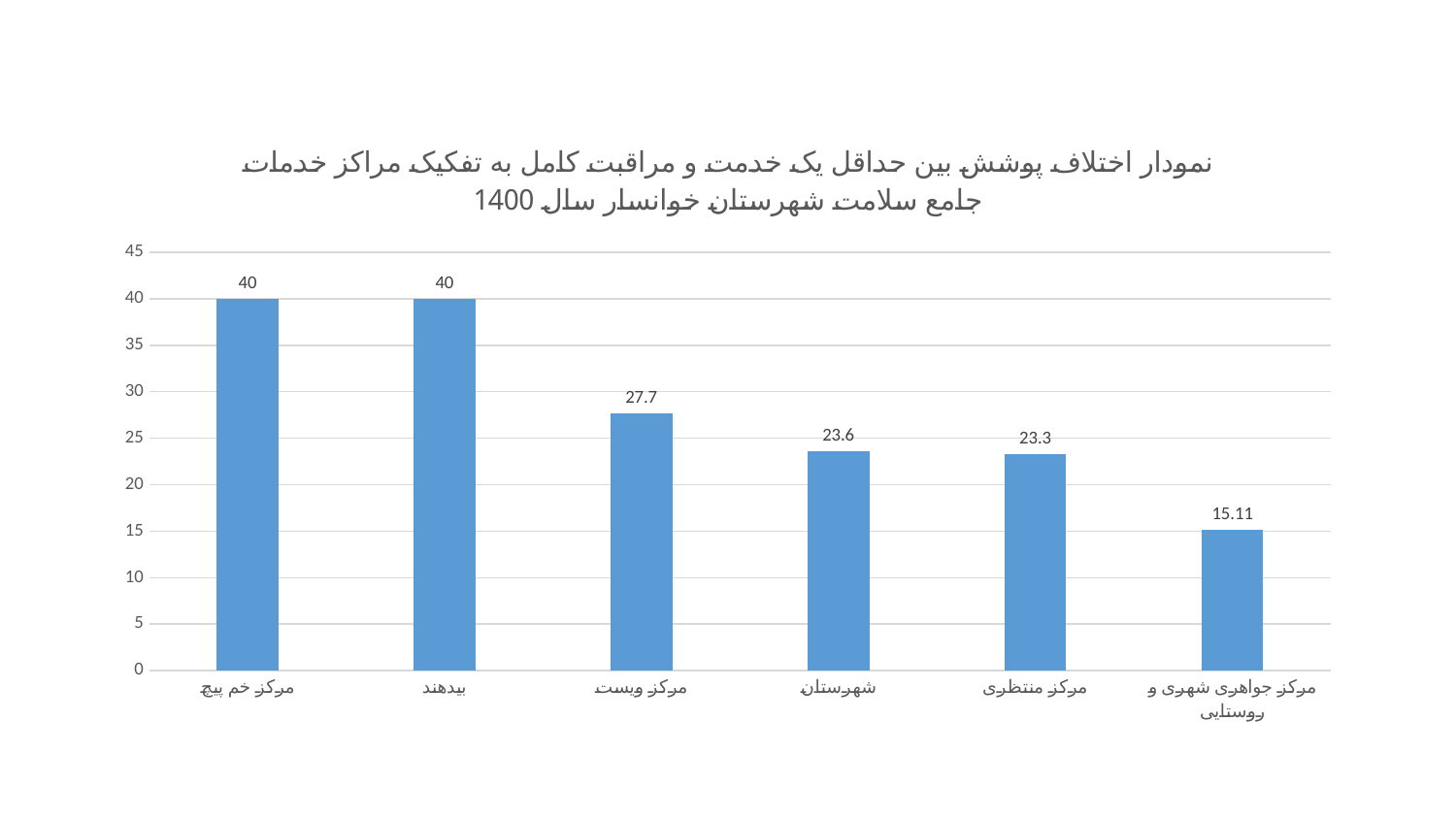
Do the values rise or fall from left to right along the x axis? Fall What is the value for بیدهند? 40 What is the value for مرکز جواهری شهری و روستایی? 15.11 Which is larger, the value for مرکز ویست or the value for مرکز منتظری? مرکز ویست What kind of chart is shown on the slide? Bar chart Which category has the lowest value? مرکز جواهری شهری و روستایی What is the value for شهرستان? 23.6 What is the value for مرکز منتظری? 23.3 What is the value for مرکز ویست? 27.7 What is the difference between the values for شهرستان and مرکز جواهری شهری و روستایی? 8.49 What is the difference between the values for مرکز خم پیچ and مرکز ویست? 12.3 How many categories are shown on the x axis? 6